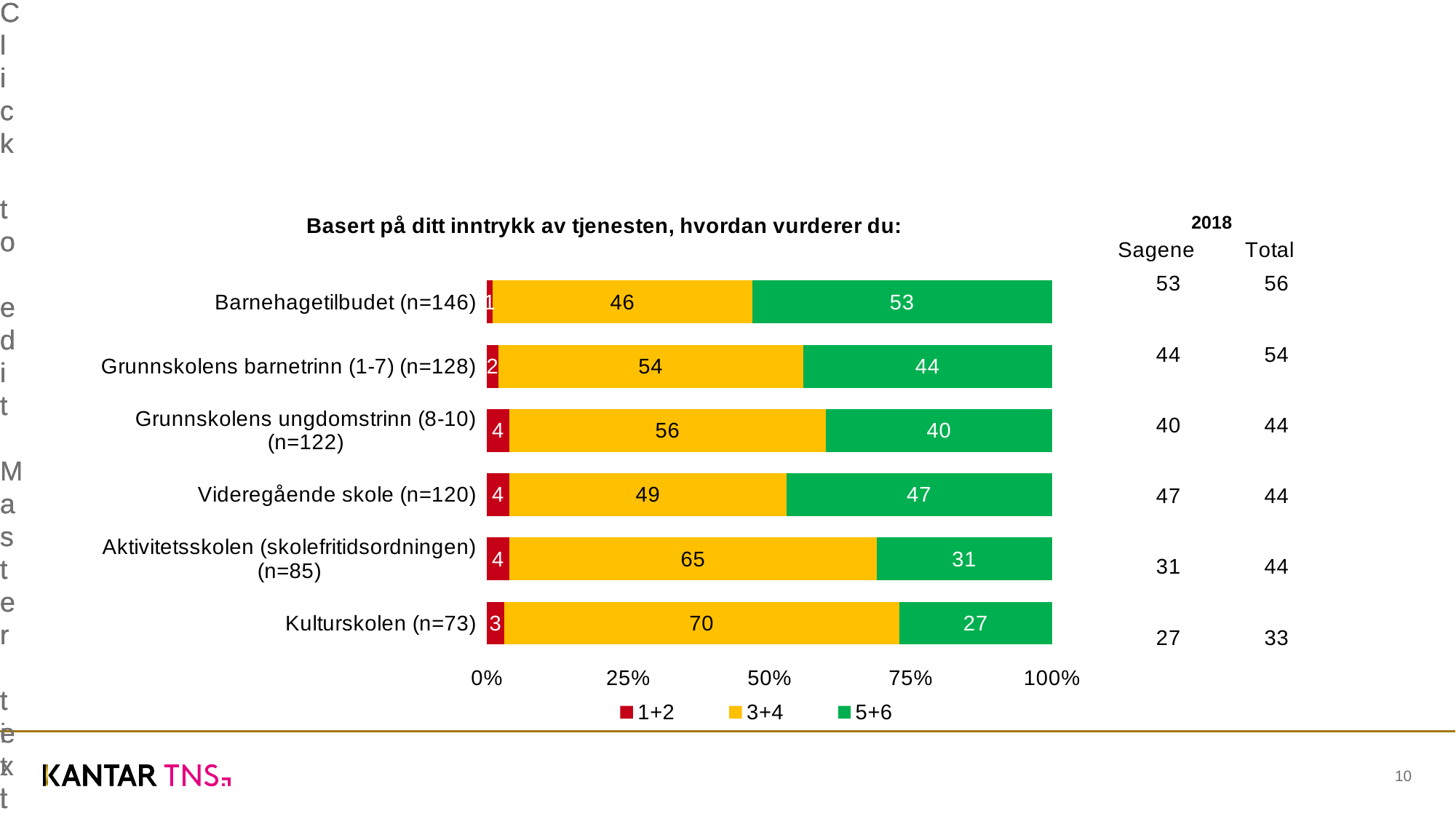
Which category has the highest 3+4 value? Kulturskolen (n=73) What is the value of the 3+4 segment for Aktivitetsskolen (skolefritidsordningen) (n=85)? 65 How many categories are shown in the chart? 6 What kind of chart is shown on the slide? Stacked bar chart What is the difference between the 3+4 value for Kulturskolen (n=73) and the 3+4 value for Barnehagetilbudet (n=146)? 24 What is the value of the 1+2 segment for Grunnskolens barnetrinn (1-7) (n=128)? 2 Which category has the lowest 3+4 value? Barnehagetilbudet (n=146) Which has a larger 5+6 value: Videregående skole (n=120) or Grunnskolens barnetrinn (1-7) (n=128)? Videregående skole (n=120) Which category has the highest 5+6 value? Barnehagetilbudet (n=146) How many series does the legend list? 3 What is the value of the 5+6 segment for Kulturskolen (n=73)? 27 What is the total of the stacked bar for Grunnskolens ungdomstrinn (8-10) (n=122)? 100